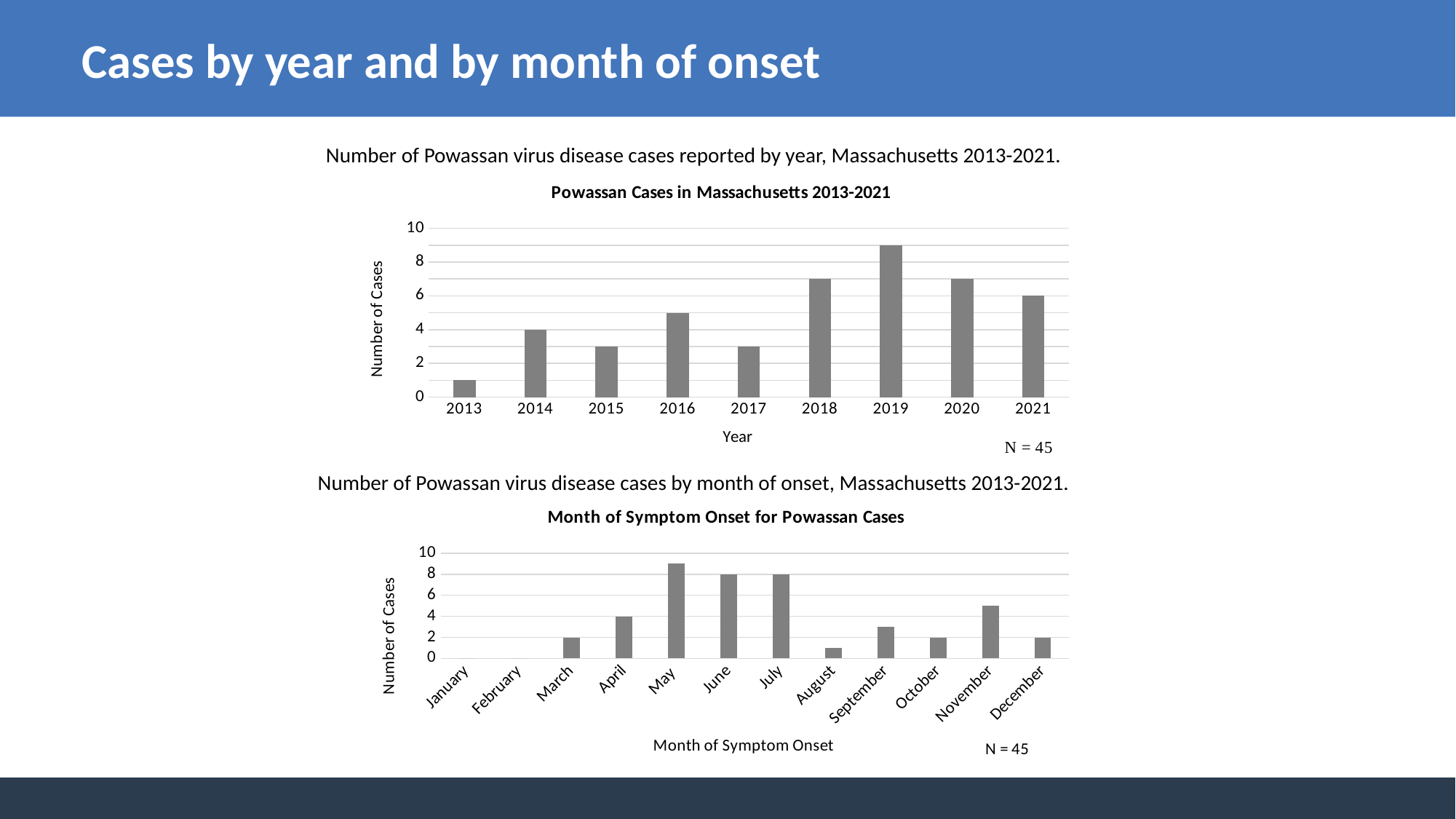
In the 'Powassan Cases in Massachusetts 2013-2021' chart, what kind of chart is shown? Bar chart In the 'Month of Symptom Onset for Powassan Cases' chart, which month has the highest number of cases? May In the 'Powassan Cases in Massachusetts 2013-2021' chart, how many cases were reported in 2014? 4 In the 'Month of Symptom Onset for Powassan Cases' chart, is the value for November greater or less than 4? greater In the 'Powassan Cases in Massachusetts 2013-2021' chart, how many cases were reported in 2021? 6 In the 'Month of Symptom Onset for Powassan Cases' chart, how many cases had onset in June? 8 In the 'Powassan Cases in Massachusetts 2013-2021' chart, is the value for 2019 greater or less than 8? greater In the 'Powassan Cases in Massachusetts 2013-2021' chart, which year has the lowest number of cases? 2013 In the 'Powassan Cases in Massachusetts 2013-2021' chart, which year has the highest number of cases? 2019 In the 'Powassan Cases in Massachusetts 2013-2021' chart, how many years are shown on the x axis? 9 In the 'Powassan Cases in Massachusetts 2013-2021' chart, which year has more cases, 2018 or 2015? 2018 In the 'Month of Symptom Onset for Powassan Cases' chart, how many months are shown on the x axis? 12